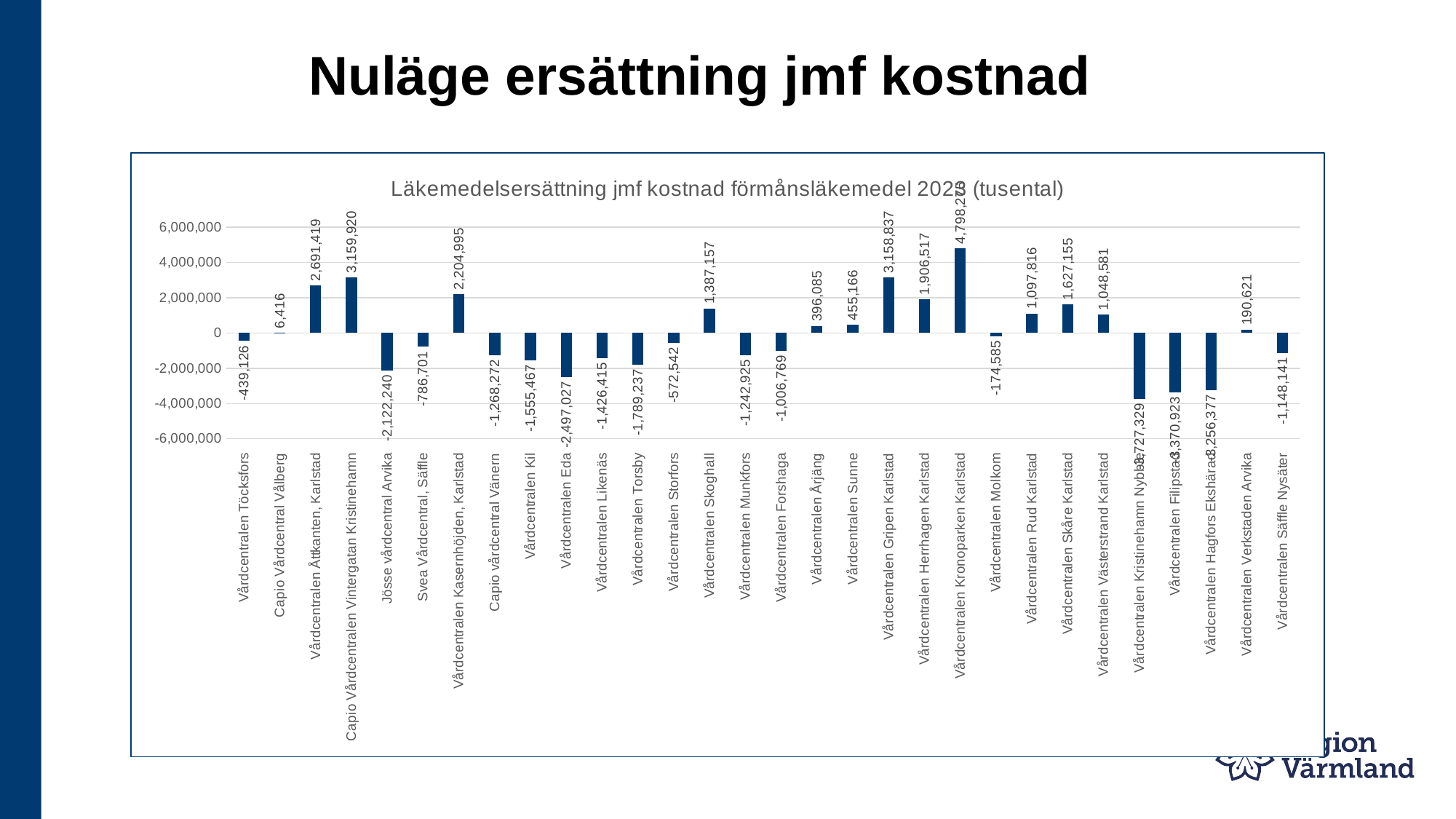
What is the value for Capio Vårdcentralen Vintergatan Kristinehamn? 3,159,920 Is the value for Vårdcentralen Filipstad greater or less than -2,000,000? less What is the value for Vårdcentralen Eda? -2,497,027 Which vårdcentral has the lowest value in the chart? Vårdcentralen Kristinehamn Nybble What is the title of the chart? Läkemedelsersättning jmf kostnad förmånsläkemedel 2023 (tusental) What is the value for Vårdcentralen Skoghall? 1,387,157 What is the value for Capio Vårdcentral Vålberg? 6,416 What kind of chart is shown on the slide? bar chart How many vårdcentraler (categories) are plotted in the chart? 30 Which vårdcentral has the highest value in the chart? Vårdcentralen Kronoparken Karlstad What is the difference between the values for Vårdcentralen Åttkanten, Karlstad and Vårdcentralen Kasernhöjden, Karlstad? 486,424 Which has the larger value, Vårdcentralen Herrhagen Karlstad or Vårdcentralen Skåre Karlstad? Vårdcentralen Herrhagen Karlstad